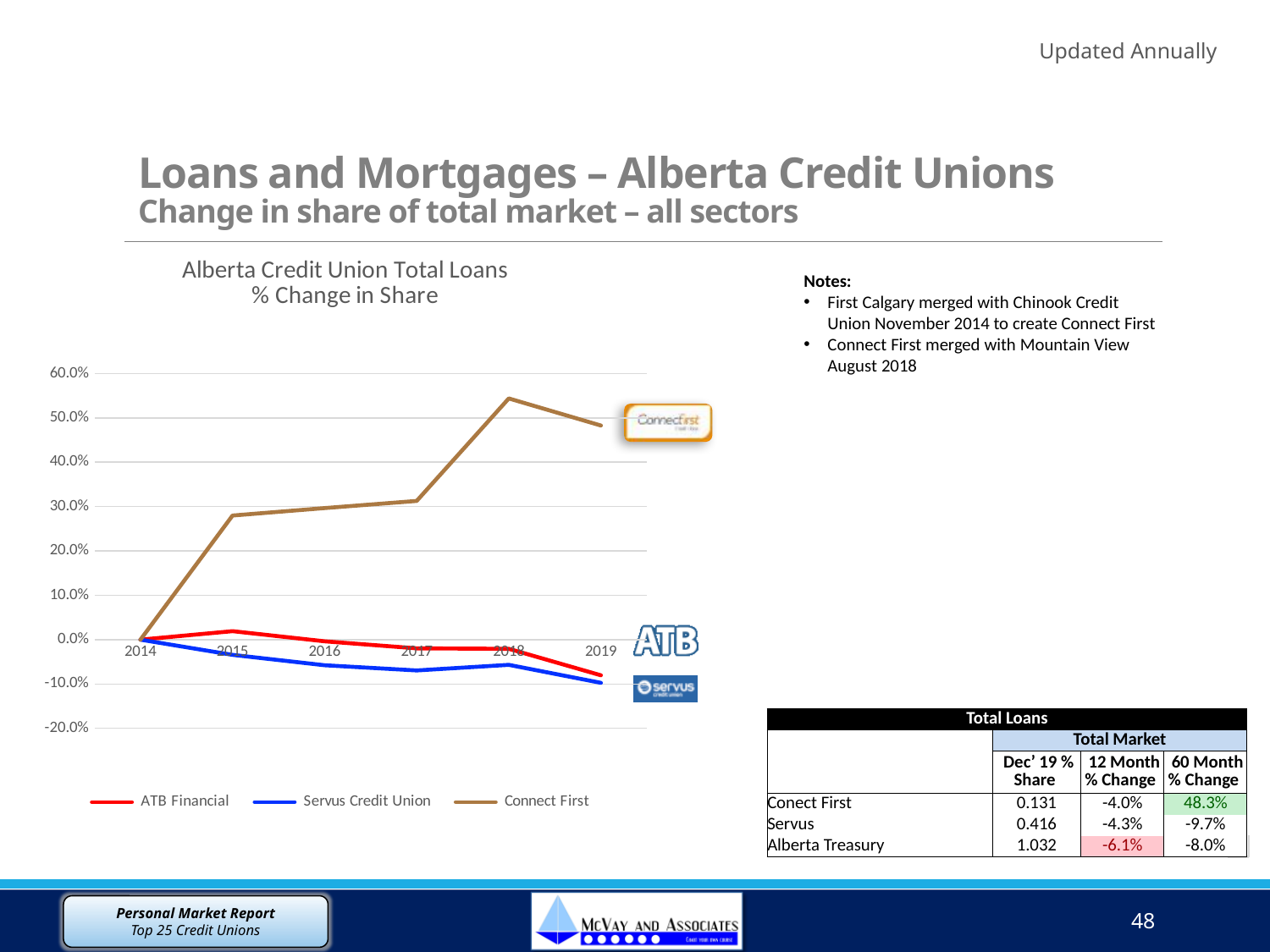
What is the title of the chart? Alberta Credit Union Total Loans % Change in Share Which is larger in 2017, the value for Connect First or the value for ATB Financial? Connect First In which year does the Connect First line reach its highest value? 2018 Is the value for Servus Credit Union in 2019 greater or less than 0.0%? less How many years are plotted along the x axis of the chart? 6 Is the value for Connect First in 2018 greater or less than 50.0%? greater Is the value for Connect First in 2015 greater or less than 20.0%? greater How many series does the chart legend list? 3 Which series has the highest value in 2019? Connect First Does the Servus Credit Union line generally rise or fall from 2014 to 2019? Fall What kind of chart is shown on the slide? Line chart